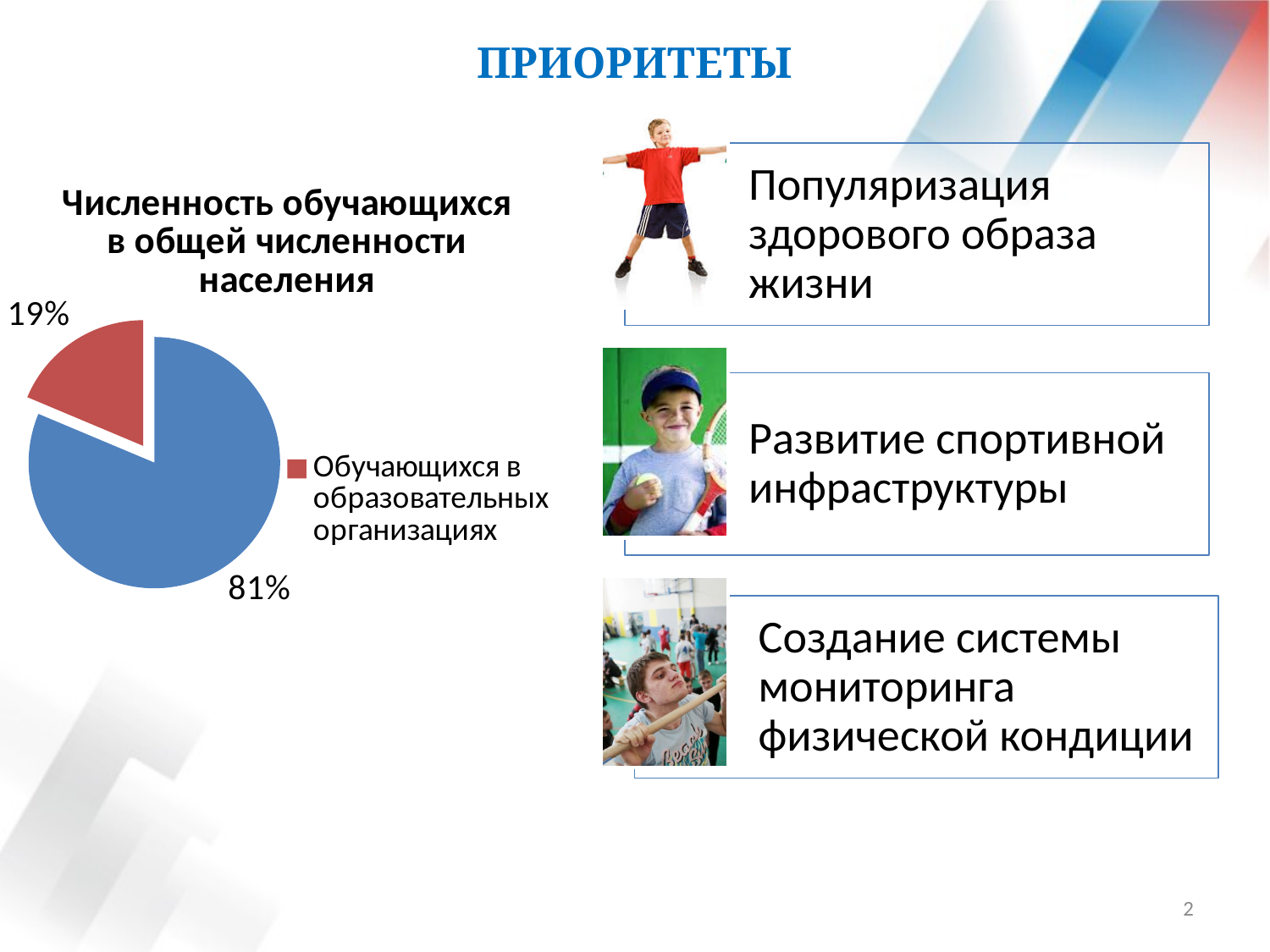
What is the difference in percentage points between the blue slice and the red slice? 62 percentage points What is the total of the two percentages shown on the pie chart? 100% What is the title of the pie chart? Численность обучающихся в общей численности населения What percentage is shown for the larger (blue) slice of the pie chart? 81% What share of the pie does the slice labelled "Обучающихся в образовательных организациях" represent? 19% How many entries does the legend of the pie chart list? 1 What kind of chart is shown on the slide? Pie chart How many slices does the pie chart have? 2 Which slice is larger, the blue slice or the red slice? The blue slice What colour is the slice for "Обучающихся в образовательных организациях" in the legend? Red What percentage is shown for the red slice of the pie chart? 19% Which slice of the pie chart is the smallest? Обучающихся в образовательных организациях (19%)